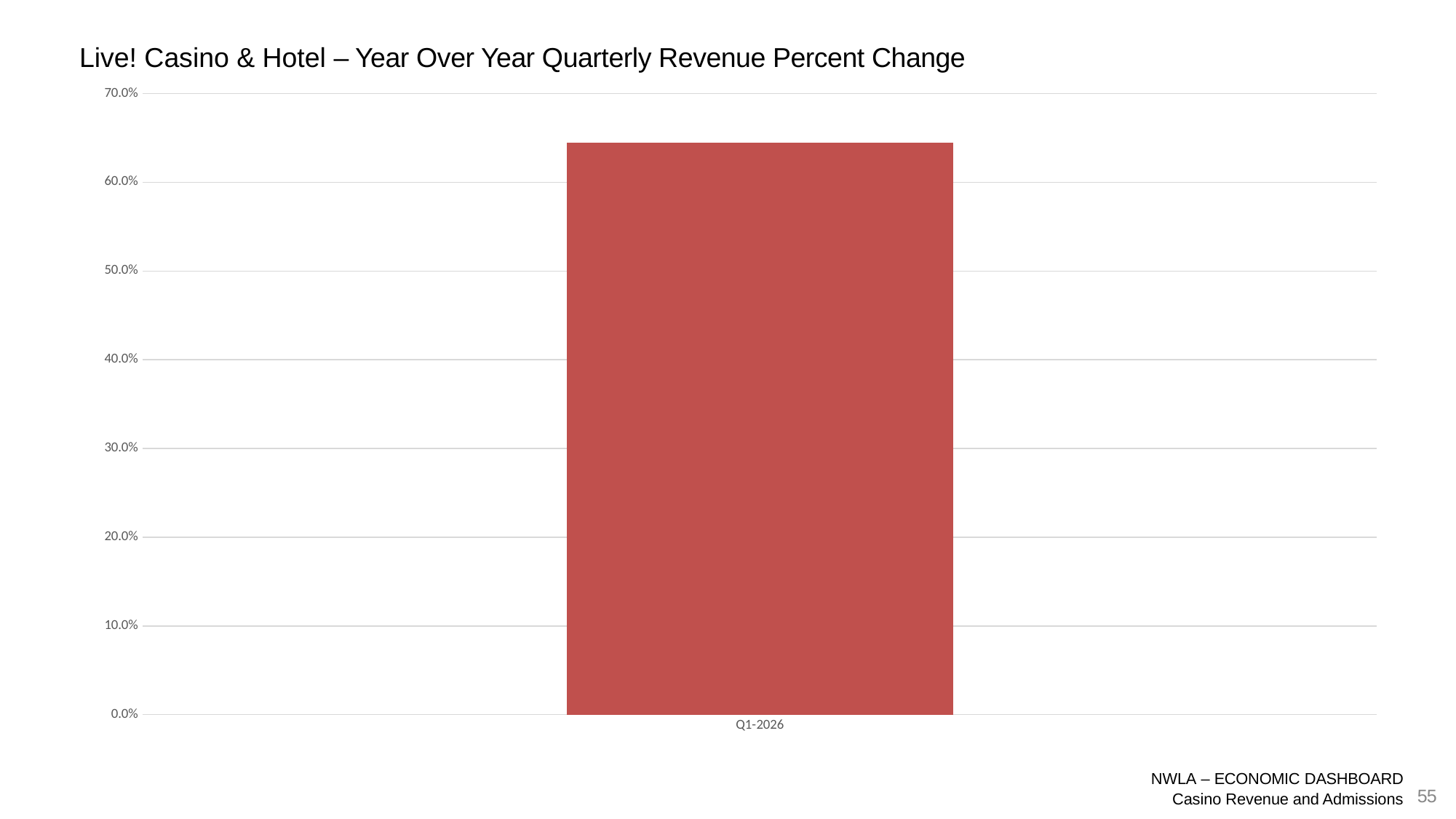
Is the value for Q1-2026 greater or less than 70.0%? less Which quarter is shown on the x axis of the chart? Q1-2026 How many bars are plotted in the chart? 1 What is the highest value shown on the y axis of the chart? 70.0% What kind of chart is shown on the slide? bar chart What is the title of the chart? Live! Casino & Hotel – Year Over Year Quarterly Revenue Percent Change Is the value for Q1-2026 greater or less than 50.0%? greater Is the value for Q1-2026 greater or less than 60.0%? greater